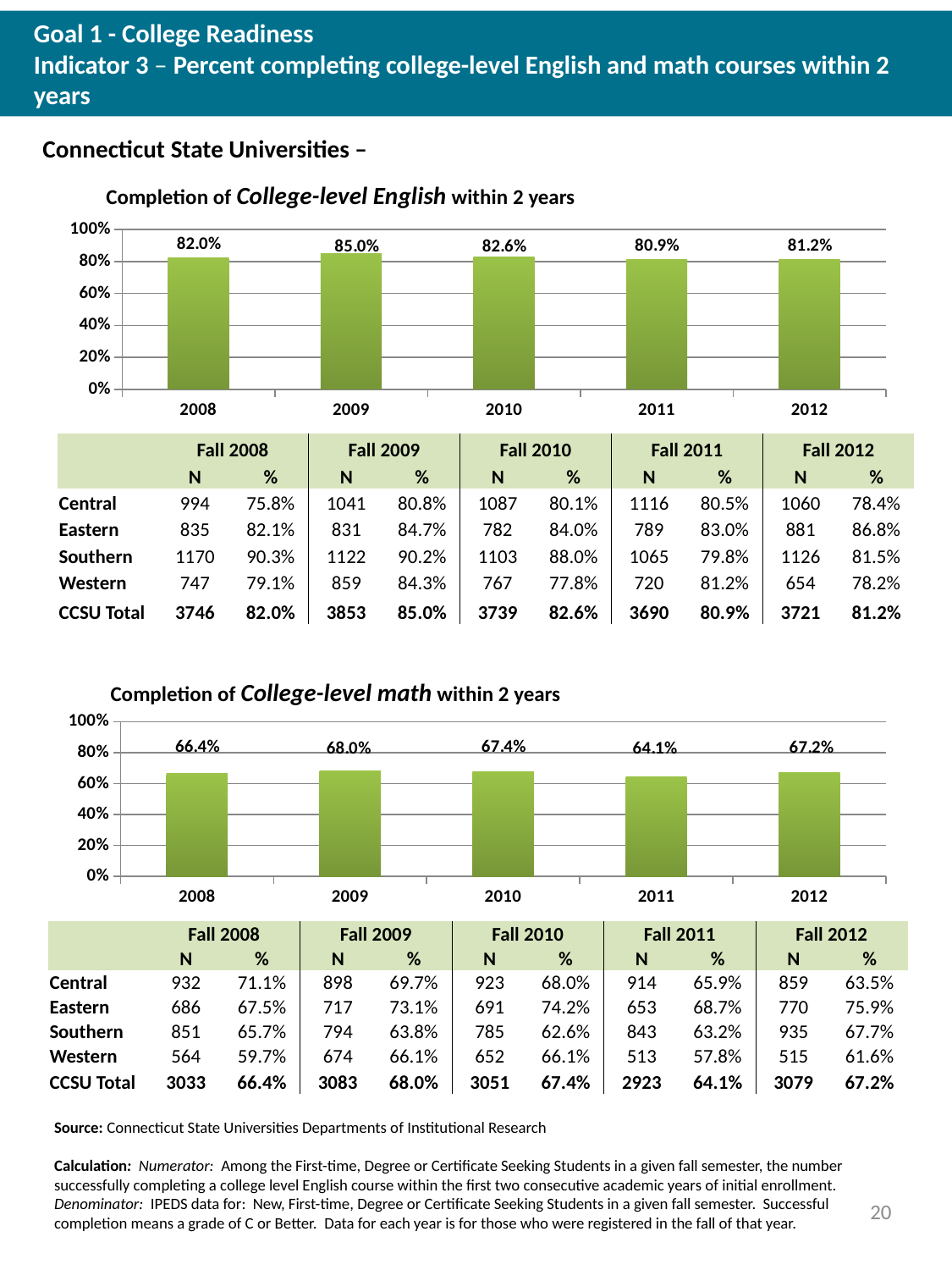
In the 'Completion of College-level English within 2 years' chart, which year has the highest value? 2009 In the 'Completion of College-level math within 2 years' chart, which year has the lowest value? 2011 What type of chart is the 'Completion of College-level English within 2 years' chart? Bar chart In the 'Completion of College-level English within 2 years' chart, what is the difference between the 2009 and 2011 values? 4.1% In the 'Completion of College-level math within 2 years' chart, what is the difference between the 2008 and 2012 values? 0.8% In the 'Completion of College-level math within 2 years' chart, what is the value for 2011? 64.1% In the 'Completion of College-level math within 2 years' chart, is the value for 2009 greater or less than 80%? less In the 'Completion of College-level English within 2 years' chart, how many years are plotted? 5 In the 'Completion of College-level math within 2 years' chart, is the value for 2010 larger than the value for 2012? Yes In the 'Completion of College-level English within 2 years' chart, which year has the lowest value? 2011 In the 'Completion of College-level math within 2 years' chart, which year has the highest value? 2009 In the 'Completion of College-level English within 2 years' chart, what is the value for 2009? 85.0%